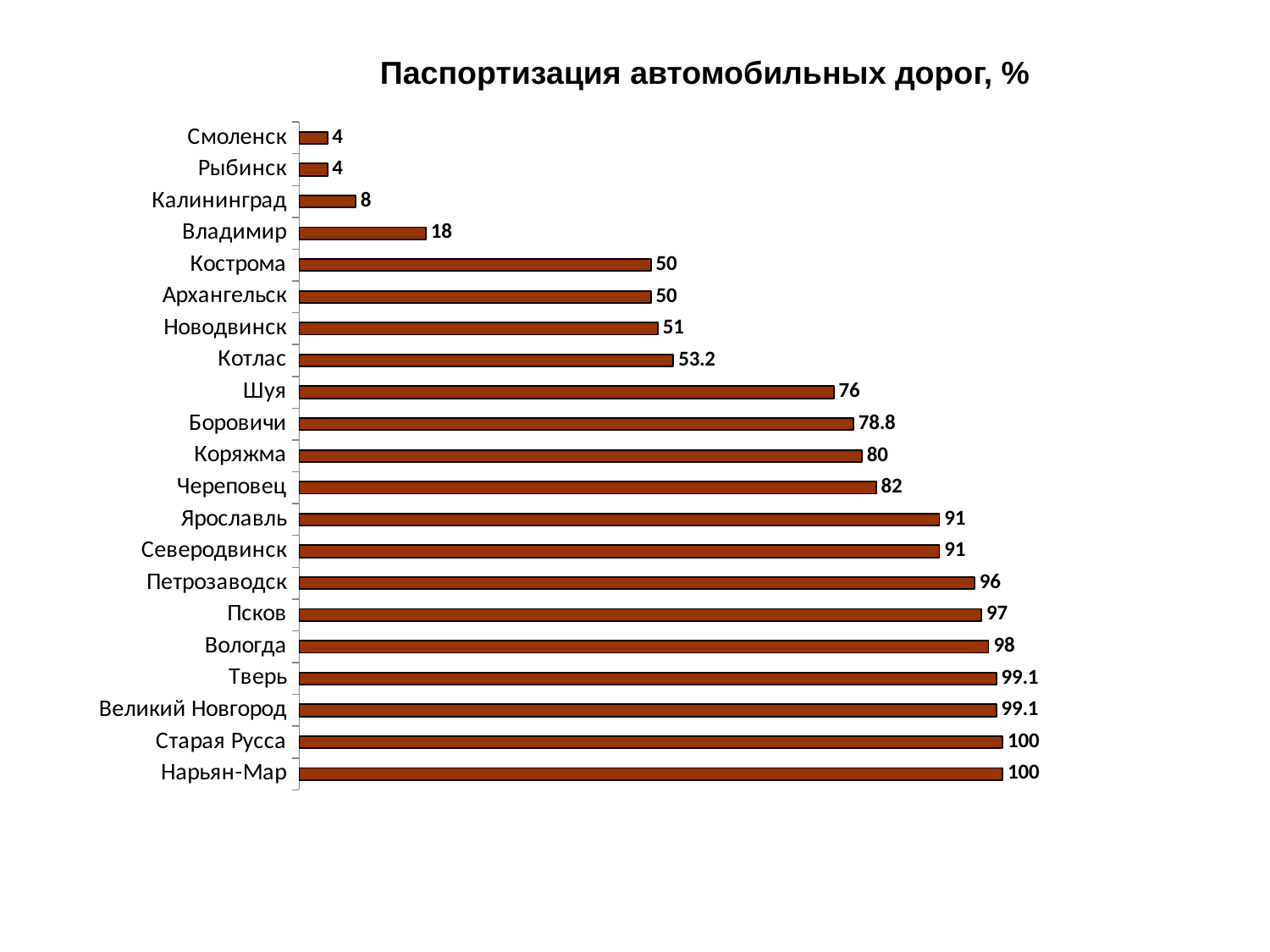
What is the value for Петрозаводск? 96 What is the difference between the values for Вологда and Калининград? 90 What is the value for Владимир? 18 How many cities are shown on the chart? 21 What is the difference between the values for Тверь and Череповец? 17.1 Which has a larger value, Шуя or Коряжма? Коряжма What is the highest value shown on the chart? 100 What is the lowest value shown on the chart? 4 What is the title of the chart? Паспортизация автомобильных дорог, % What is the value for Боровичи? 78.8 What kind of chart is shown on the slide? Bar chart What is the value for Котлас? 53.2